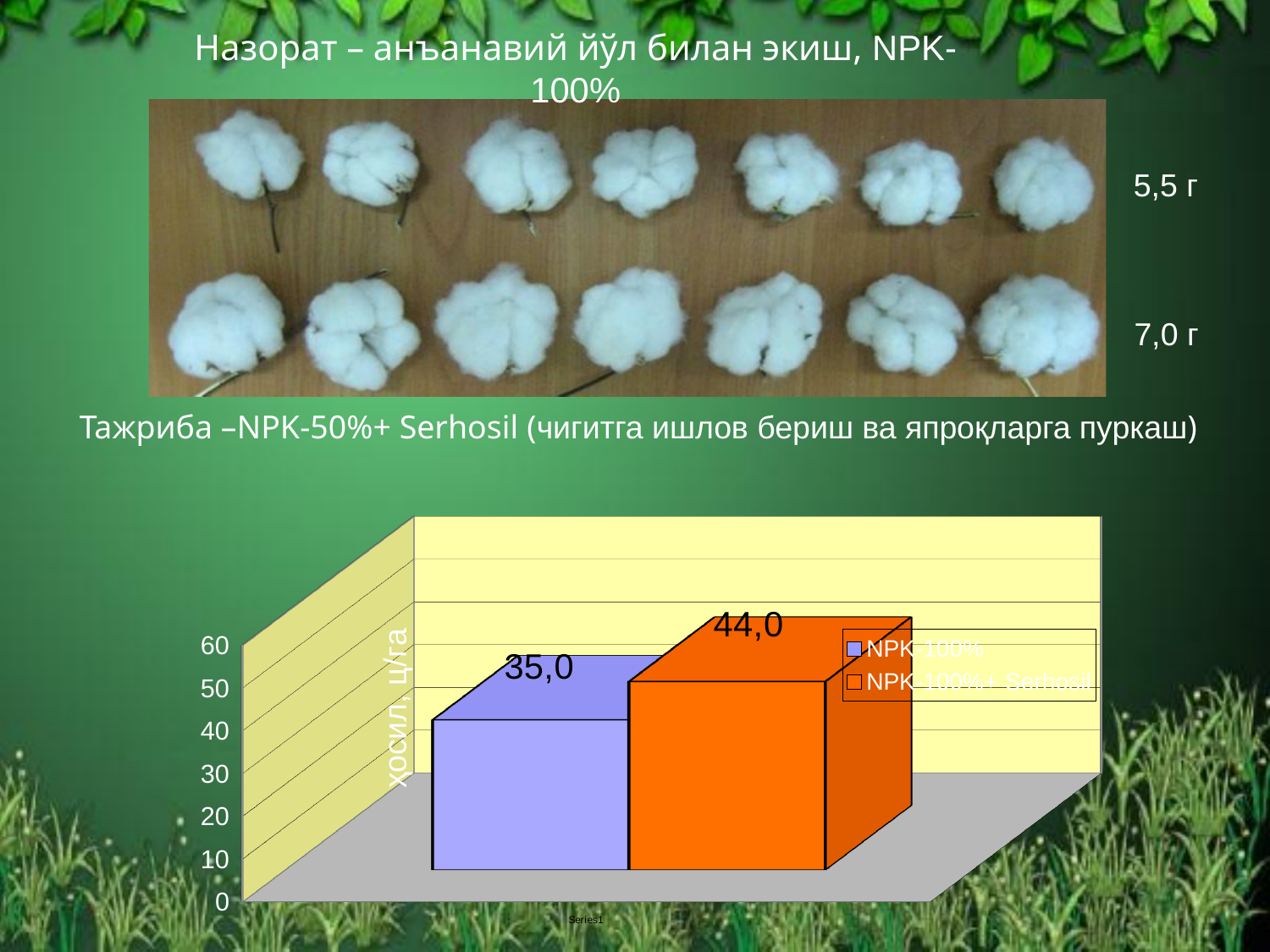
What is the difference between the NPK-100%+ Serhosil value and the NPK-100% value? 9,0 What kind of chart is shown on the slide? bar chart Is the value for NPK-100% greater or less than 40? less Which series has the lower value in the bar chart? NPK-100% What is the value for NPK-100%+ Serhosil in the bar chart? 44,0 What colour is the bar for NPK-100%+ Serhosil? orange What is the value for NPK-100% in the bar chart? 35,0 Which series has the higher value in the bar chart? NPK-100%+ Serhosil What is the label on the vertical axis of the chart? ҳосил, ц/га How many series does the legend of the chart list? 2 Is the value for NPK-100% larger or smaller than the value for NPK-100%+ Serhosil? smaller Is the value for NPK-100%+ Serhosil greater or less than 40? greater